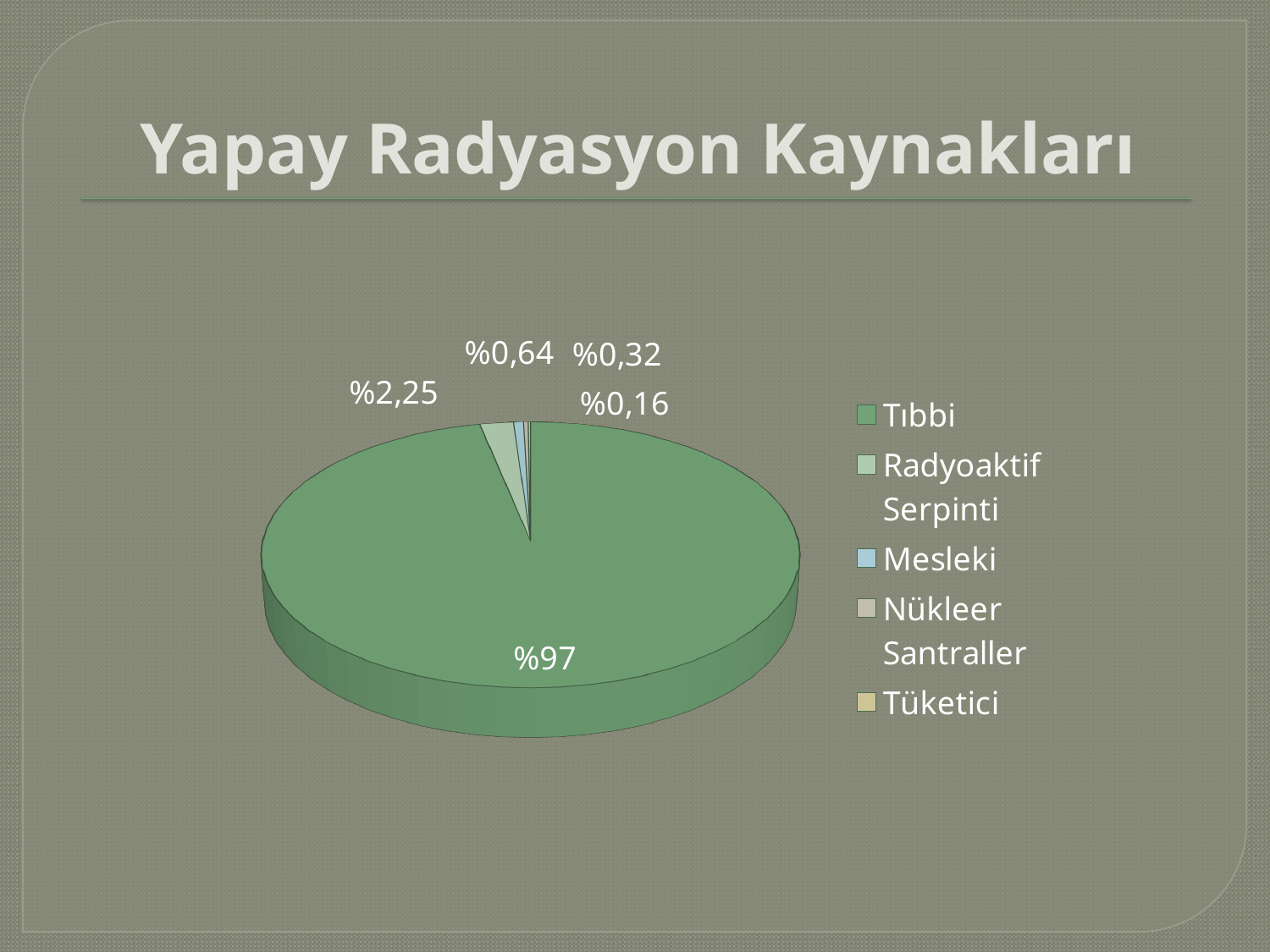
Which category has the largest slice of the pie? Tıbbi What kind of chart is shown on the slide? Pie chart Which is larger, Radyoaktif Serpinti or Mesleki? Radyoaktif Serpinti What is the value shown for Tüketici? %0,16 How many categories does the pie chart have? 5 What share of the pie does Tıbbi have? %97 Which category has the smallest slice of the pie? Tüketici What is the value shown for Radyoaktif Serpinti? %2,25 What is the difference between the Tıbbi share and the Radyoaktif Serpinti share? %94,75 What is the value shown for Mesleki? %0,64 What is the value shown for Nükleer Santraller? %0,32 What is the title of the chart on the slide? Yapay Radyasyon Kaynakları